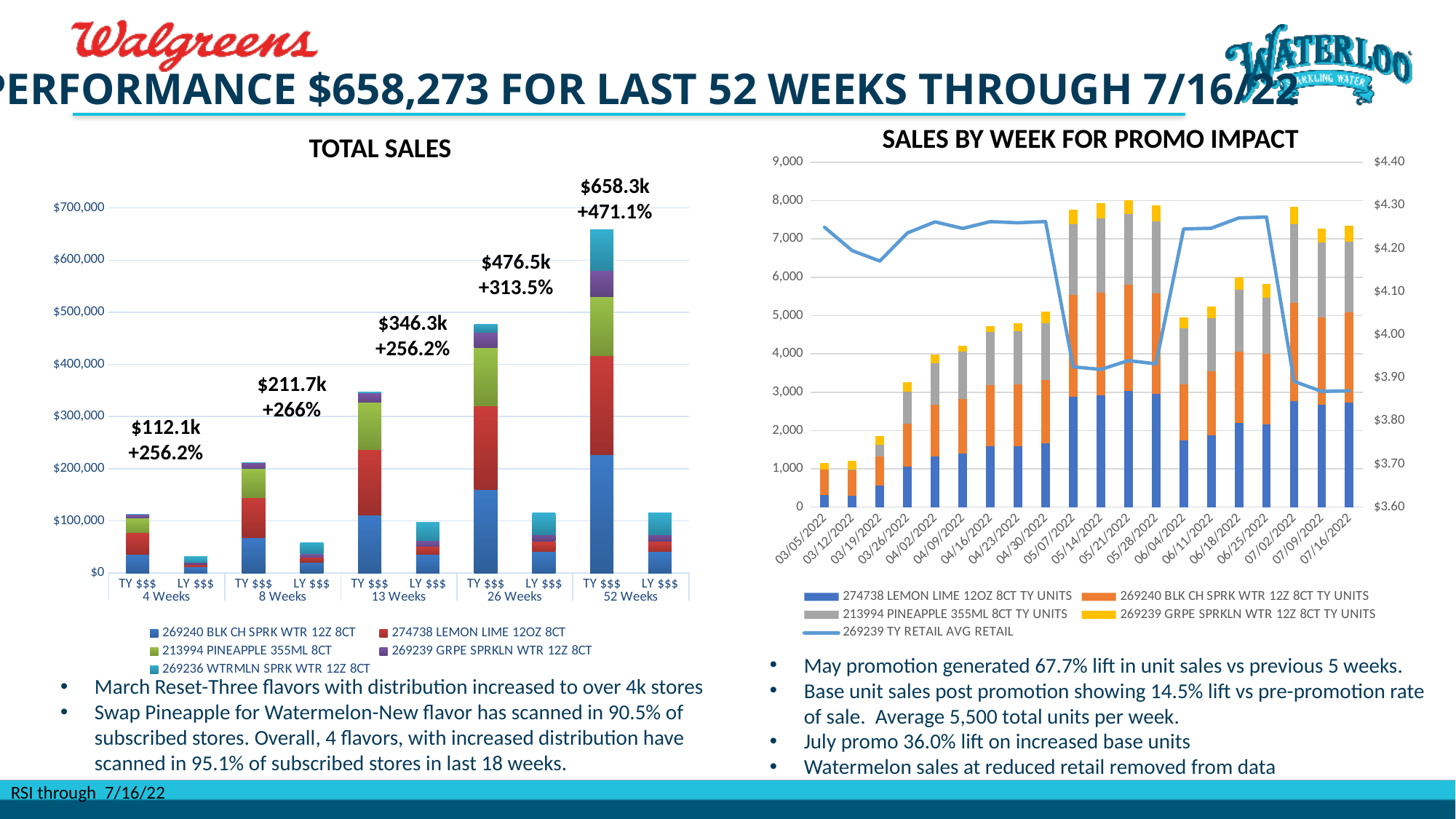
How many week periods are shown on the x axis of the TOTAL SALES chart? 5 In the TOTAL SALES chart, what is the TY $$$ total labelled for 52 Weeks? $658.3k In the TOTAL SALES chart, is the LY $$$ bar for 52 Weeks greater or less than $200,000? less In the SALES BY WEEK FOR PROMO IMPACT chart, is the total units bar for 05/21/2022 greater or less than 7,000? greater What kind of chart is the TOTAL SALES chart? bar chart In the TOTAL SALES chart, what is the TY $$$ total labelled for 13 Weeks? $346.3k In the TOTAL SALES chart, do the TY $$$ totals rise or fall from 4 Weeks to 52 Weeks? rise How many series does the legend of the TOTAL SALES chart list? 5 In the TOTAL SALES chart, which period has the highest TY $$$ total? 52 Weeks In the TOTAL SALES chart, what percentage change is labelled for the 26 Weeks period? +313.5% In the TOTAL SALES chart, what is the difference between the TY $$$ totals for 52 Weeks and 26 Weeks? $181.8k How many weeks are shown on the x axis of the SALES BY WEEK FOR PROMO IMPACT chart? 20